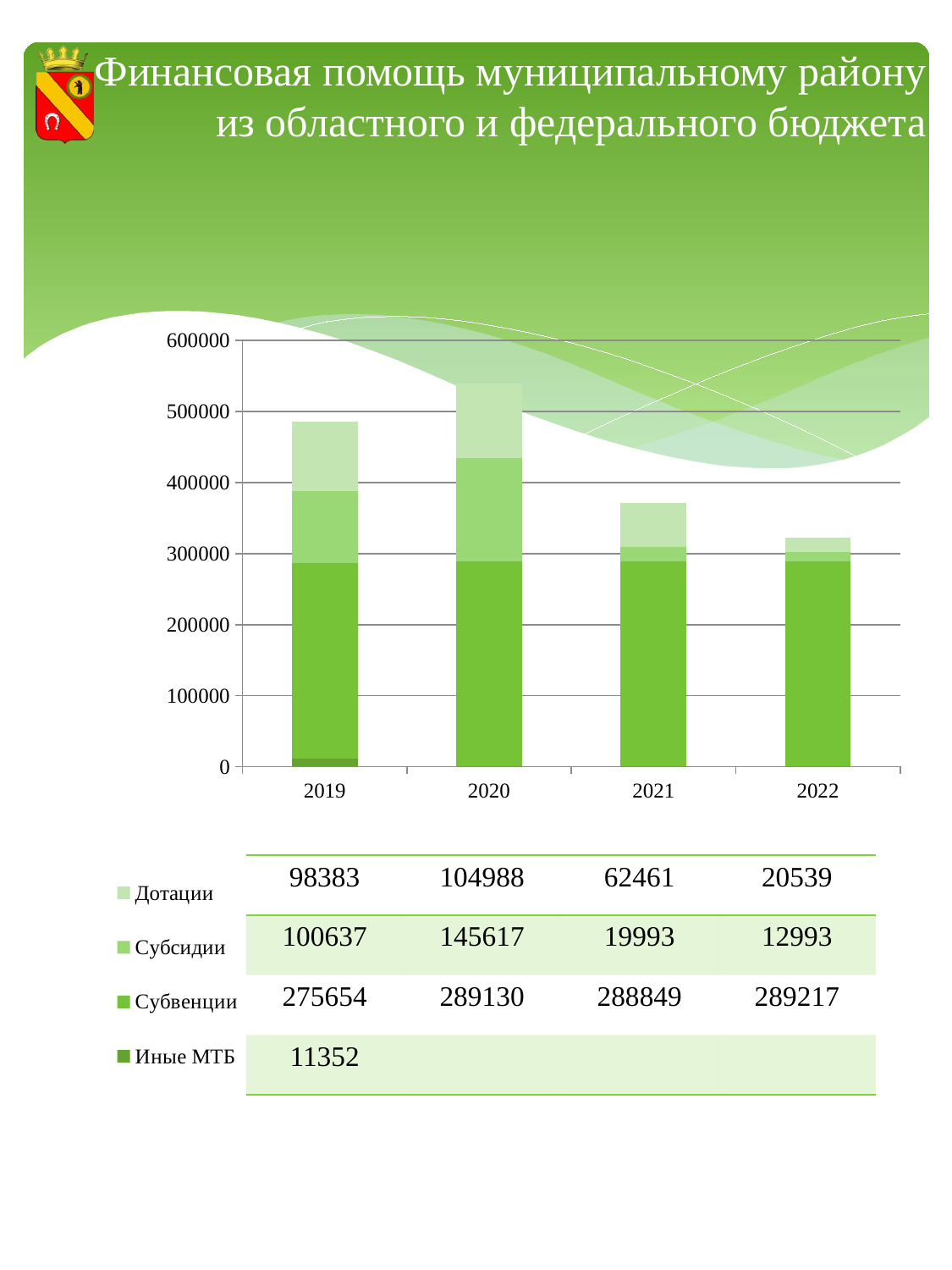
Does the total height of the stacked bars rise or fall from 2020 to 2022? fall How many years are shown on the x axis? 4 How many series does the legend list? 4 What is the total of the stacked bar for 2021? 371303 What is the value of Иные МТБ for 2019? 11352 What is the value of Субсидии for 2021? 19993 Which is larger, Дотации in 2019 or Субсидии in 2019? Субсидии in 2019 What type of chart is shown on the slide? stacked bar chart In which year is Субсидии highest? 2020 What is the value of Дотации for 2020? 104988 In which year is Дотации lowest? 2022 What is the difference between Субсидии in 2020 and Субсидии in 2019? 44980